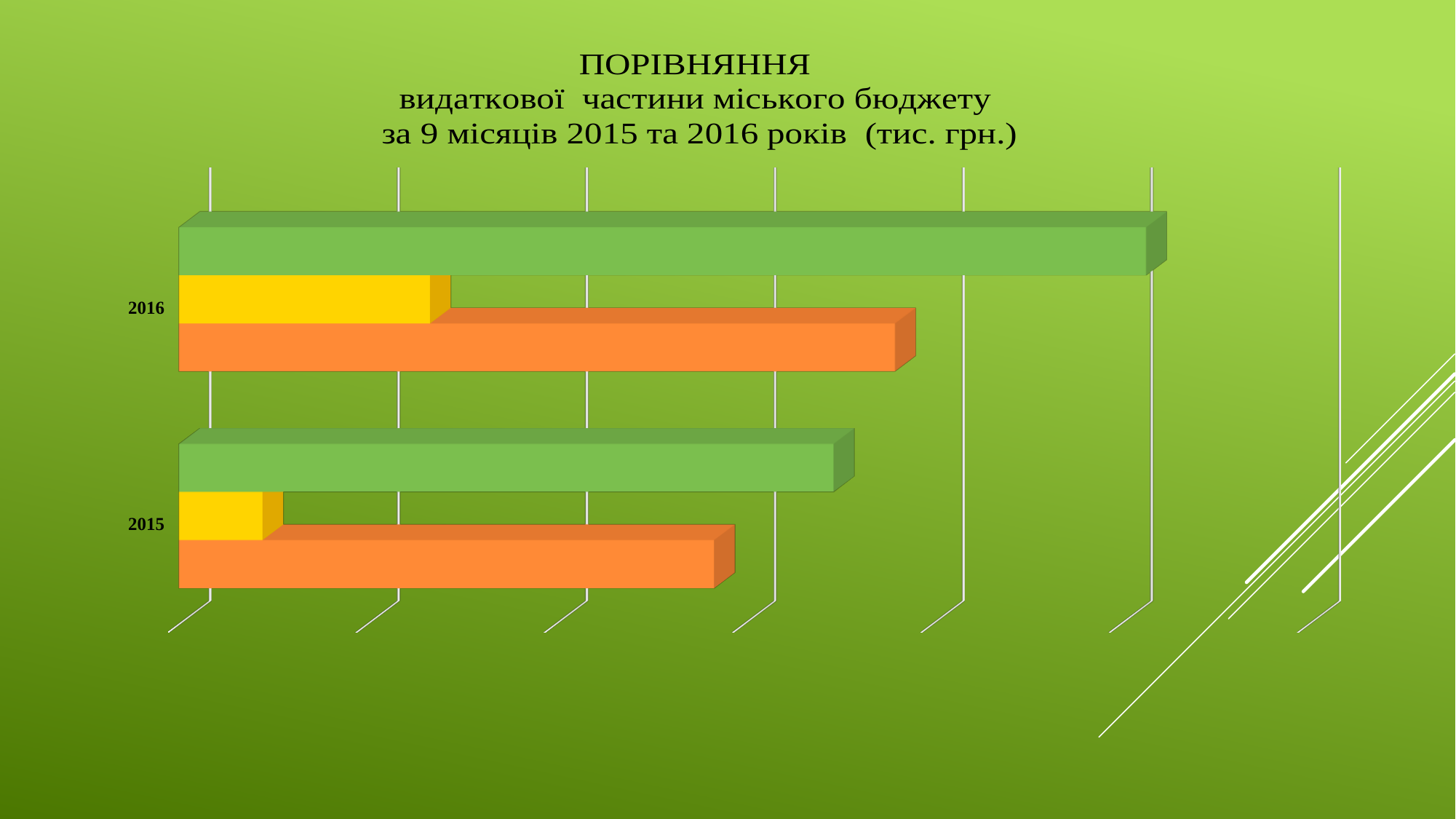
What kind of chart is shown on the slide? bar chart How many year categories are shown on the vertical axis of the chart? 2 Which coloured bar is the shortest for 2015? yellow In what units are the values in the chart expressed, according to the title? тис. грн. Which year has the longer yellow bar, 2015 or 2016? 2016 Which year has the longer orange bar, 2015 or 2016? 2016 Which coloured bar is the longest for 2016? green Which years are compared in the chart? 2015 and 2016 Which year contains the single longest bar in the chart? 2016 How many bars are plotted for each year in the chart? 3 Do the bar values rise or fall from 2015 to 2016? rise Which year has the longer green bar, 2015 or 2016? 2016